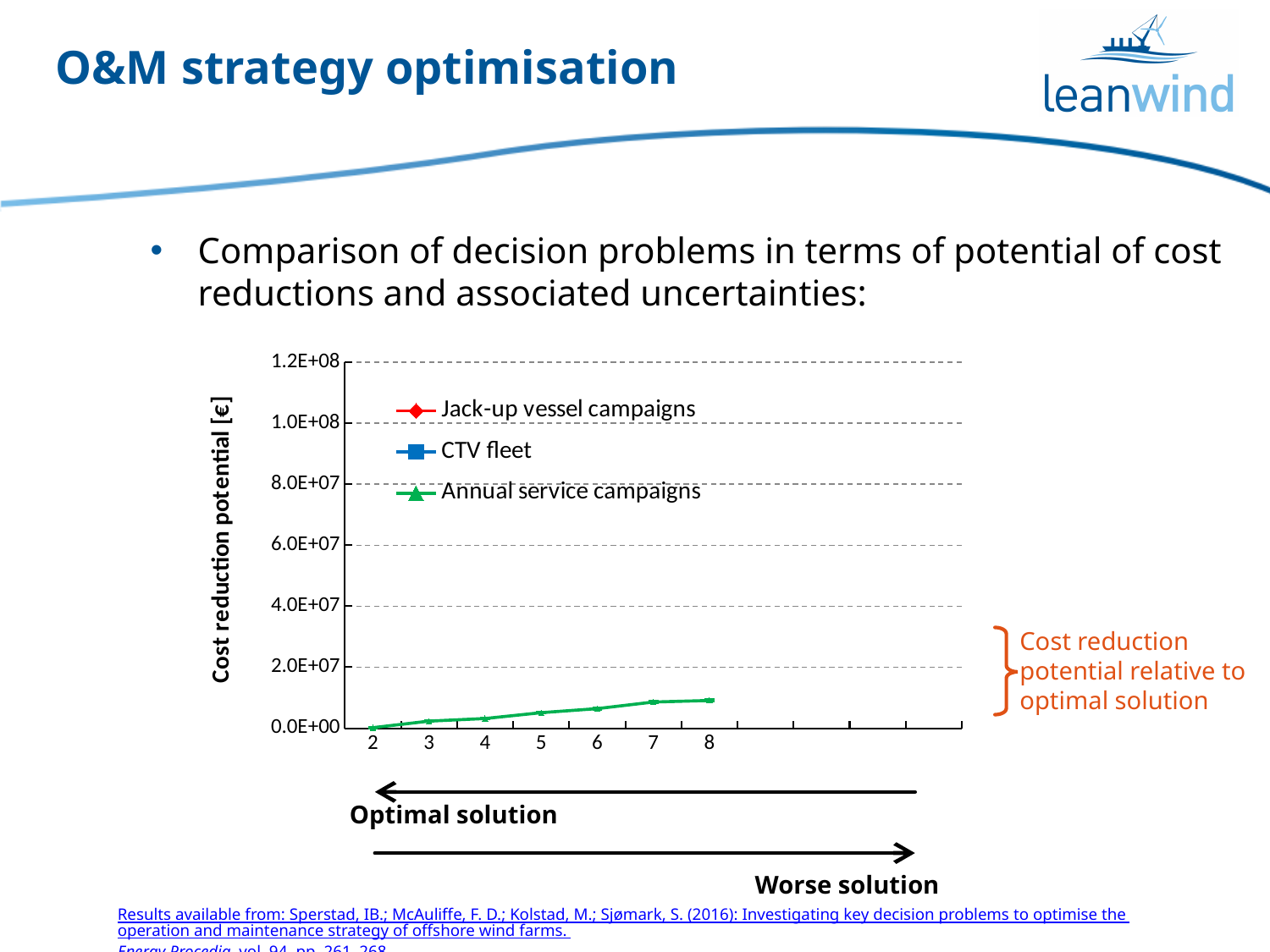
What is the highest tick value shown on the chart's vertical axis? 1.2E+08 How many data points are plotted for the Annual service campaigns series? 7 Is the value of the Annual service campaigns series at x = 8 greater or less than 2.0E+07? less What kind of chart is shown on the slide? Line chart At which x-axis value is the Annual service campaigns series lowest? 2 What is the label of the chart's vertical axis? Cost reduction potential [€] How many series does the chart's legend list? 3 Is the value of the Annual service campaigns series at x = 5 greater or less than 2.0E+07? less Does the plotted Annual service campaigns line rise or fall as the x-axis value increases from 2 to 8? Rises For the Annual service campaigns series, is the value at x = 7 larger or smaller than the value at x = 3? Larger Which series are listed in the chart's legend? Jack-up vessel campaigns, CTV fleet, Annual service campaigns For the Annual service campaigns series, which has the larger value: x = 2 or x = 6? x = 6